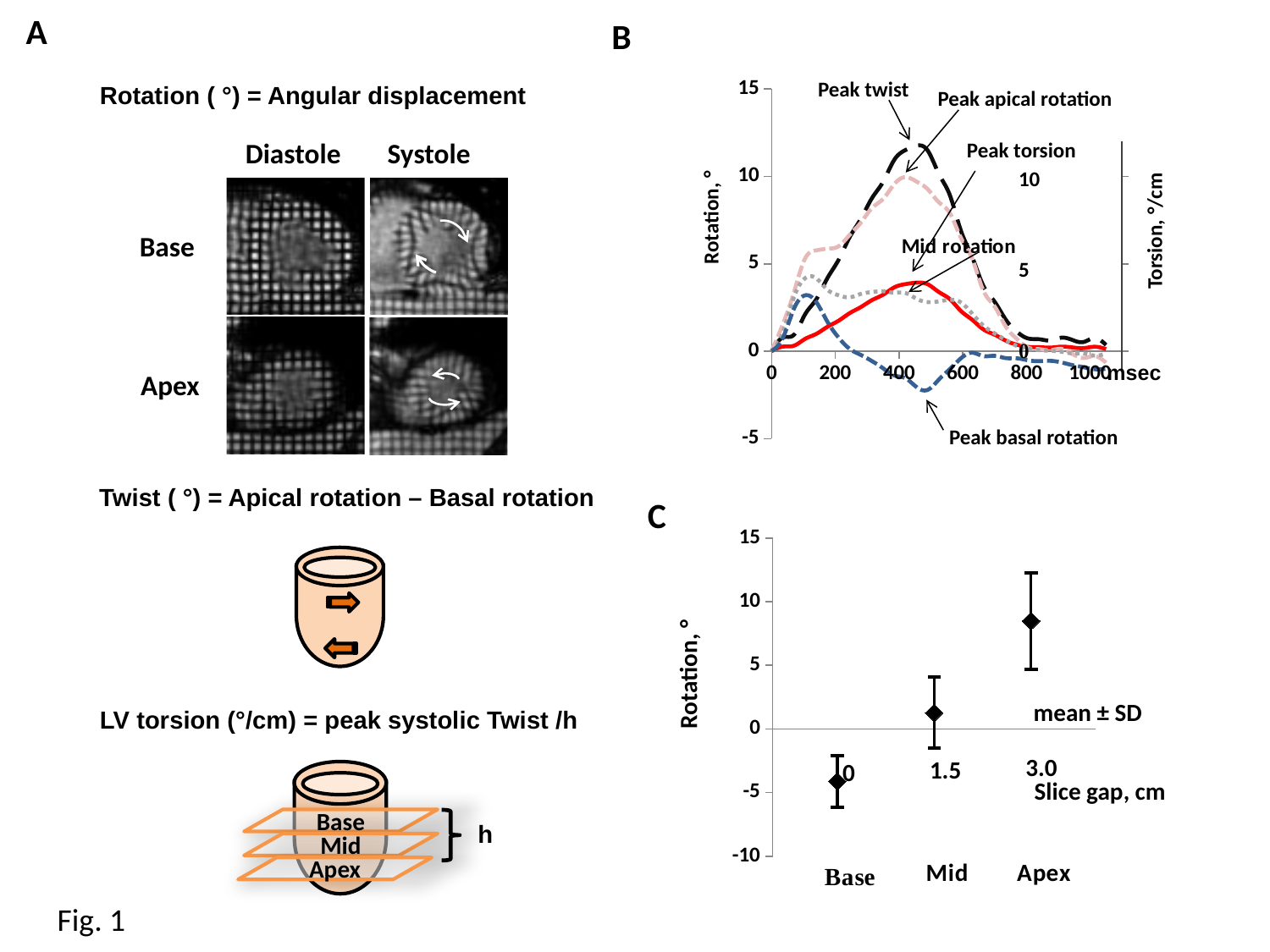
In chart C, which slice position has the highest mean rotation? Apex In chart B, what is the label of the right-hand (secondary) y axis? Torsion, °/cm In chart C, does the mean rotation rise or fall going from Base to Apex? rise In chart C, is the mean rotation for Apex greater or less than 5? greater In chart B, what is the unit shown on the x axis? msec In chart B, is the lowest point of the Peak basal rotation curve greater or less than 0? less In chart C, is the mean rotation for Base greater or less than 0? less What kind of chart is chart B (top right)? line chart In chart C, which slice position has the lowest mean rotation? Base In chart C, how many slice positions are plotted? 3